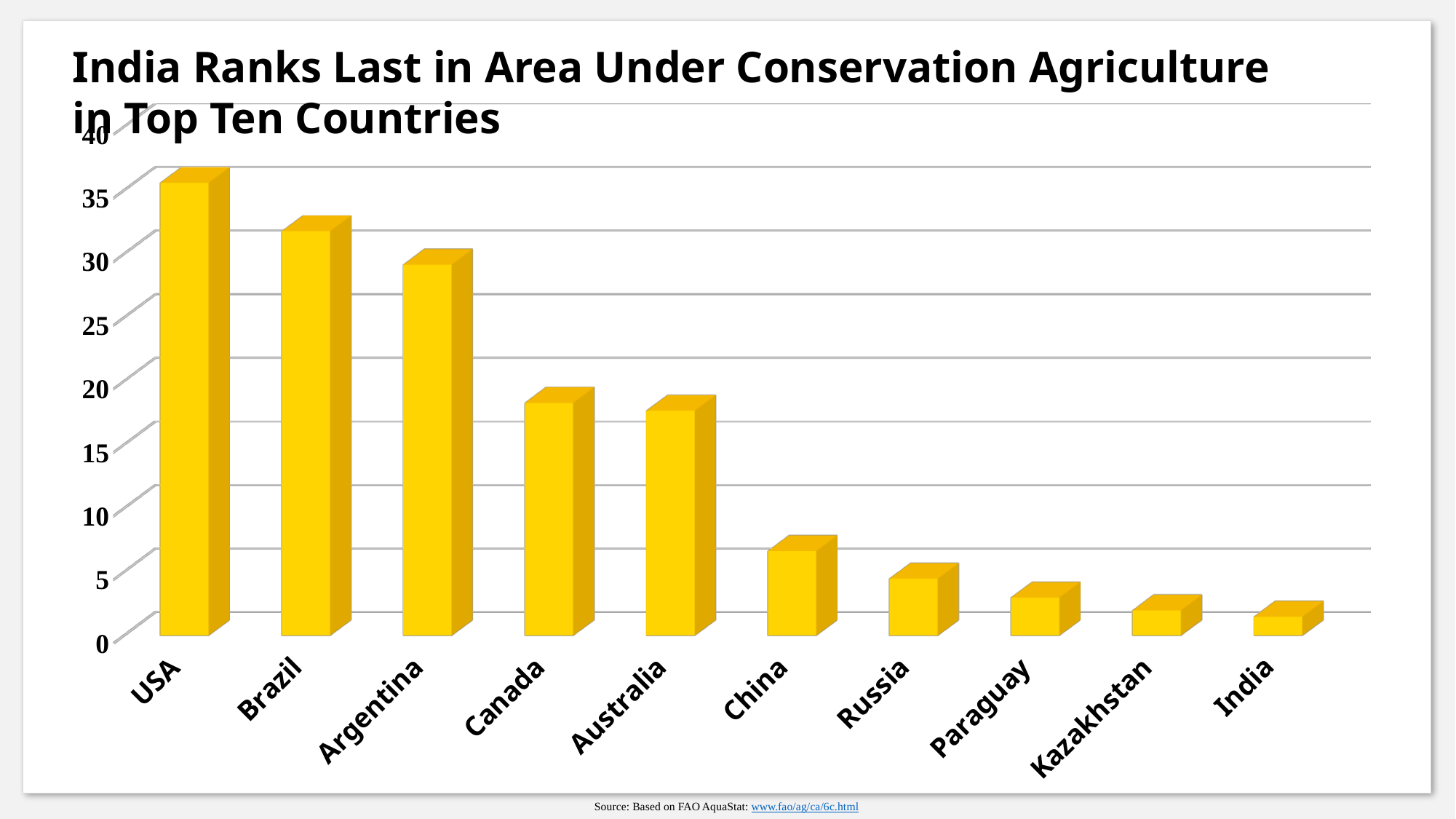
Which country has the lowest bar? India Is the value for Brazil greater or less than 25? greater What is the title of the chart? India Ranks Last in Area Under Conservation Agriculture in Top Ten Countries Is the value for Australia greater or less than 20? less Is the value for USA greater or less than 30? greater Which country has the highest bar? USA How many countries are shown on the chart? 10 Which has the larger value, USA or Brazil? USA What kind of chart is shown on the slide? Bar chart Do the values rise or fall moving from left to right along the x axis? Fall